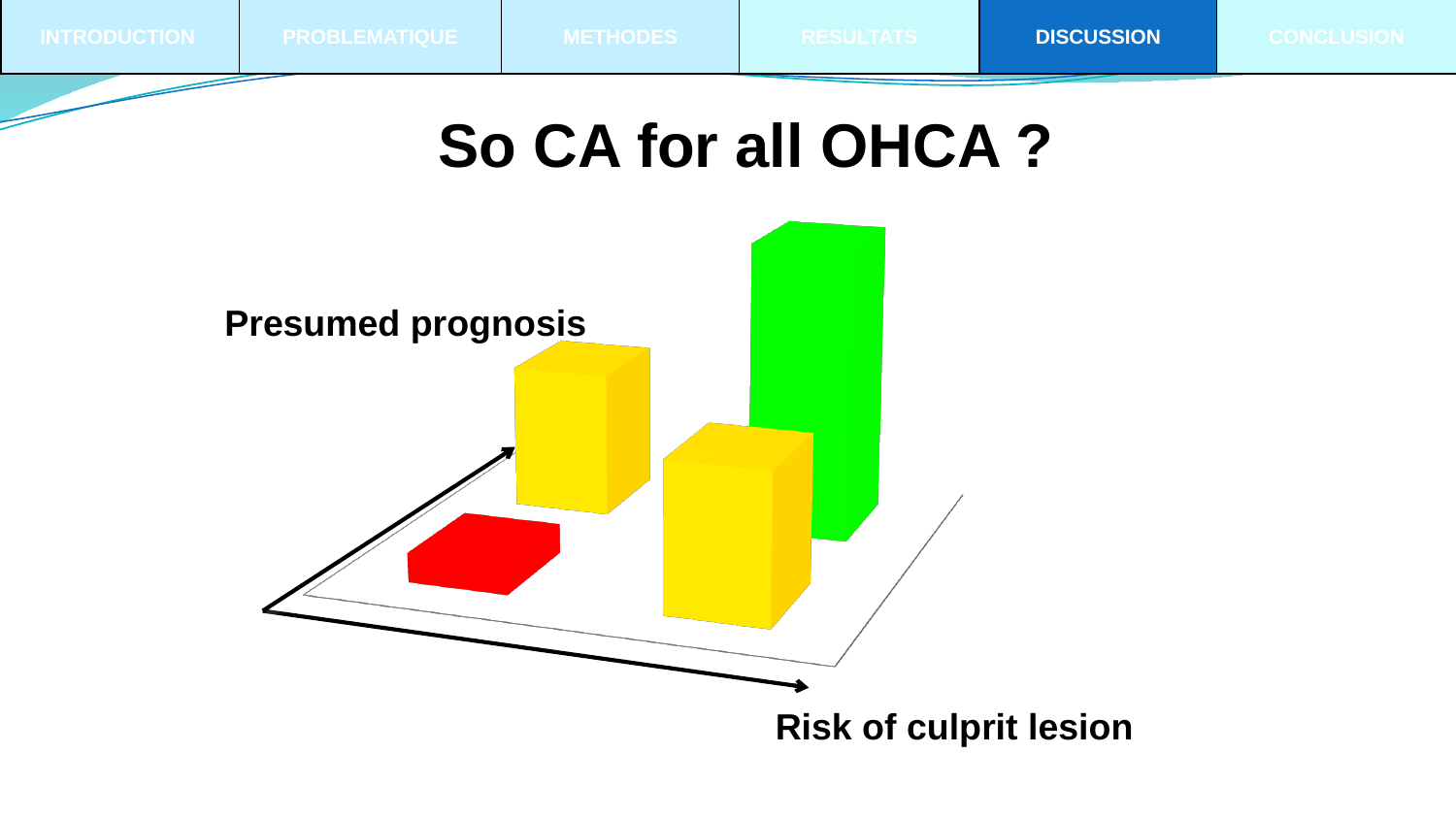
What kind of chart is shown on the slide? bar chart Which colour bar is the tallest in the chart? green How many yellow bars are in the chart? 2 What is the label of the axis pointing toward the back of the chart? Presumed prognosis Which colour bar is the shortest in the chart? red How many bars are plotted in the chart? 4 Which is taller, the green bar or the red bar? the green bar What is the label of the horizontal axis of the chart? Risk of culprit lesion Which is taller, the red bar or the yellow bar at the back? the yellow bar at the back